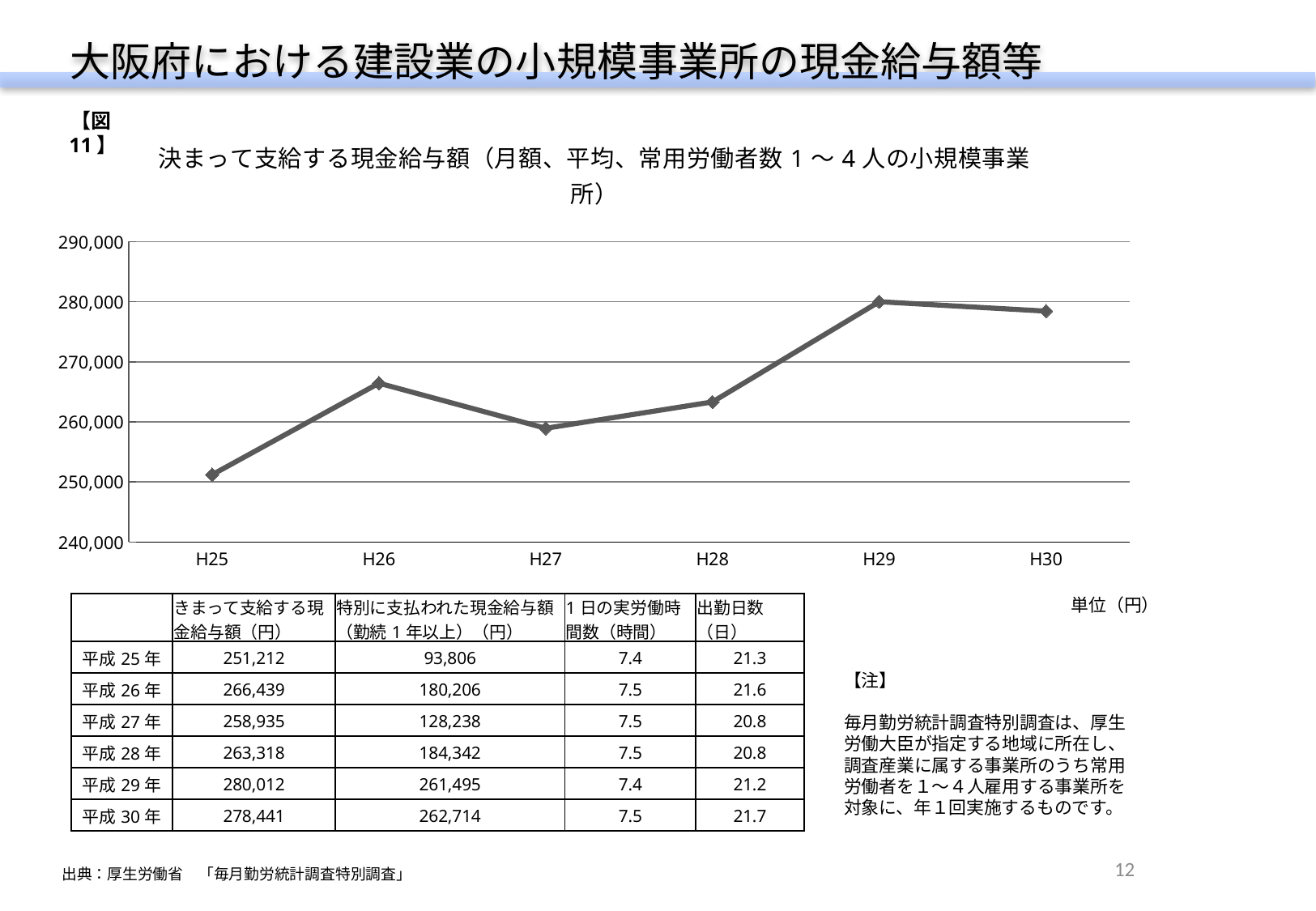
Which year has the highest value on the line chart? H29 How many data points are plotted on the line chart? 6 What is the きまって支給する現金給与額 for 平成25年 according to the table? 251,212 Is the value for H25 on the line chart greater or less than 260,000? less Which year has the lowest value on the line chart? H25 Which is larger on the line chart, the value for H26 or the value for H27? H26 By how much did the きまって支給する現金給与額 increase from 平成25年 to 平成26年? 15,227 Does the line rise or fall from H28 to H29? rise What is the きまって支給する現金給与額 for 平成29年 according to the table? 280,012 By how much does the きまって支給する現金給与額 for 平成29年 exceed that for 平成30年? 1,571 Is the value for H28 on the line chart greater or less than 260,000? greater What kind of chart is shown on the slide? line chart